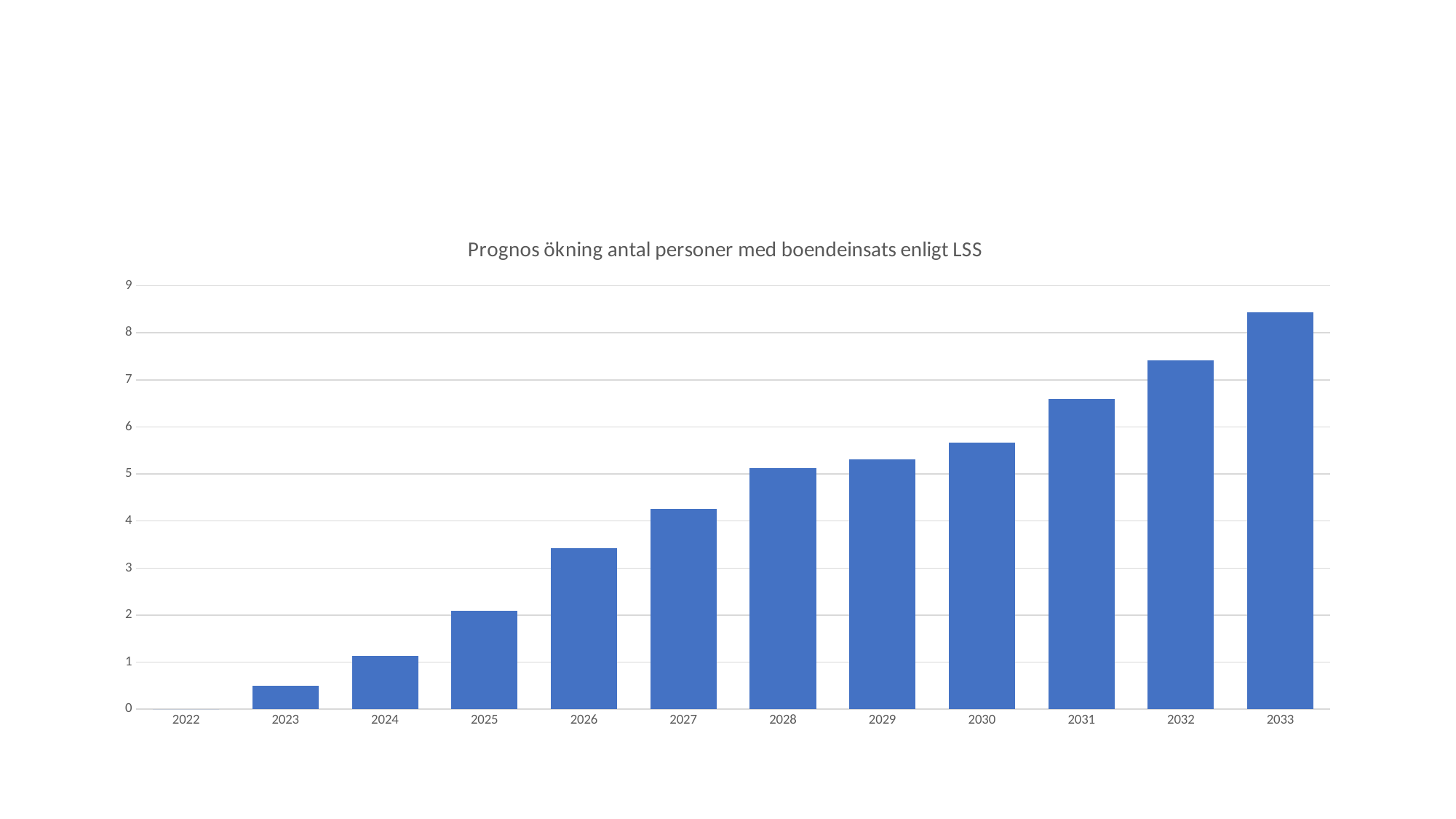
Which year has the highest bar in the chart? 2033 What kind of chart is shown on the slide? bar chart Is the value for 2023 greater or less than 1? less Is the value for 2032 greater or less than 7? greater Which year has the lowest bar in the chart? 2022 Do the values rise or fall from 2022 to 2033? rise How many years are shown on the x axis of the chart? 12 What is the title of the chart? Prognos ökning antal personer med boendeinsats enligt LSS Is the value for 2030 greater or less than 6? less Which is larger, the value for 2031 or the value for 2029? 2031